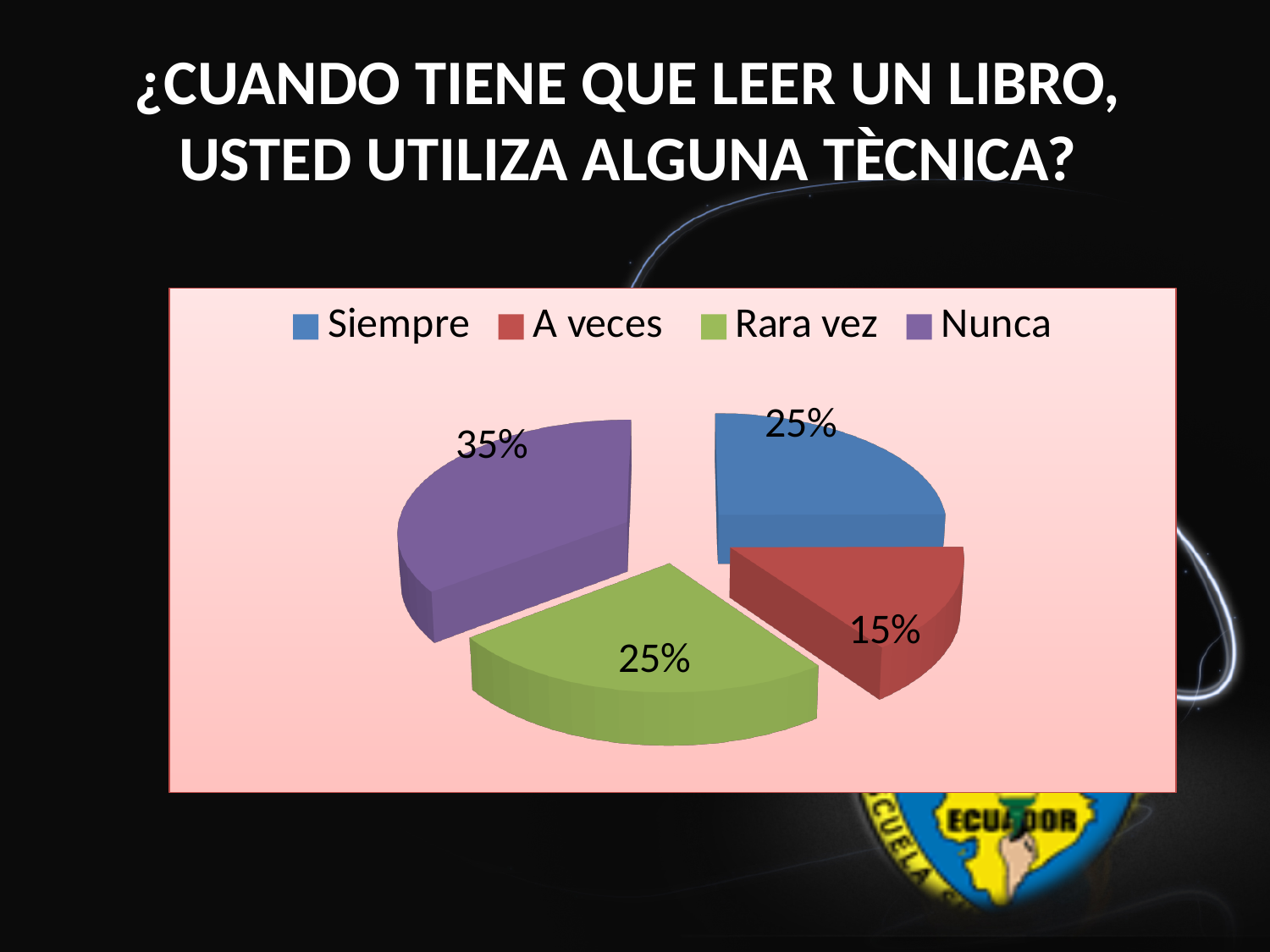
What share of the pie does Nunca have? 35% How many categories does the legend list? 4 Which category has the smallest slice of the pie? A veces What share of the pie does Siempre have? 25% Which is larger, the share for Nunca or the share for Siempre? Nunca What is the difference between the Nunca share and the A veces share? 20% What colour is the slice for Rara vez? green What share of the pie does Rara vez have? 25% What kind of chart is shown on the slide? pie chart Which category has the largest slice of the pie? Nunca What is the combined share of Siempre and Rara vez? 50%